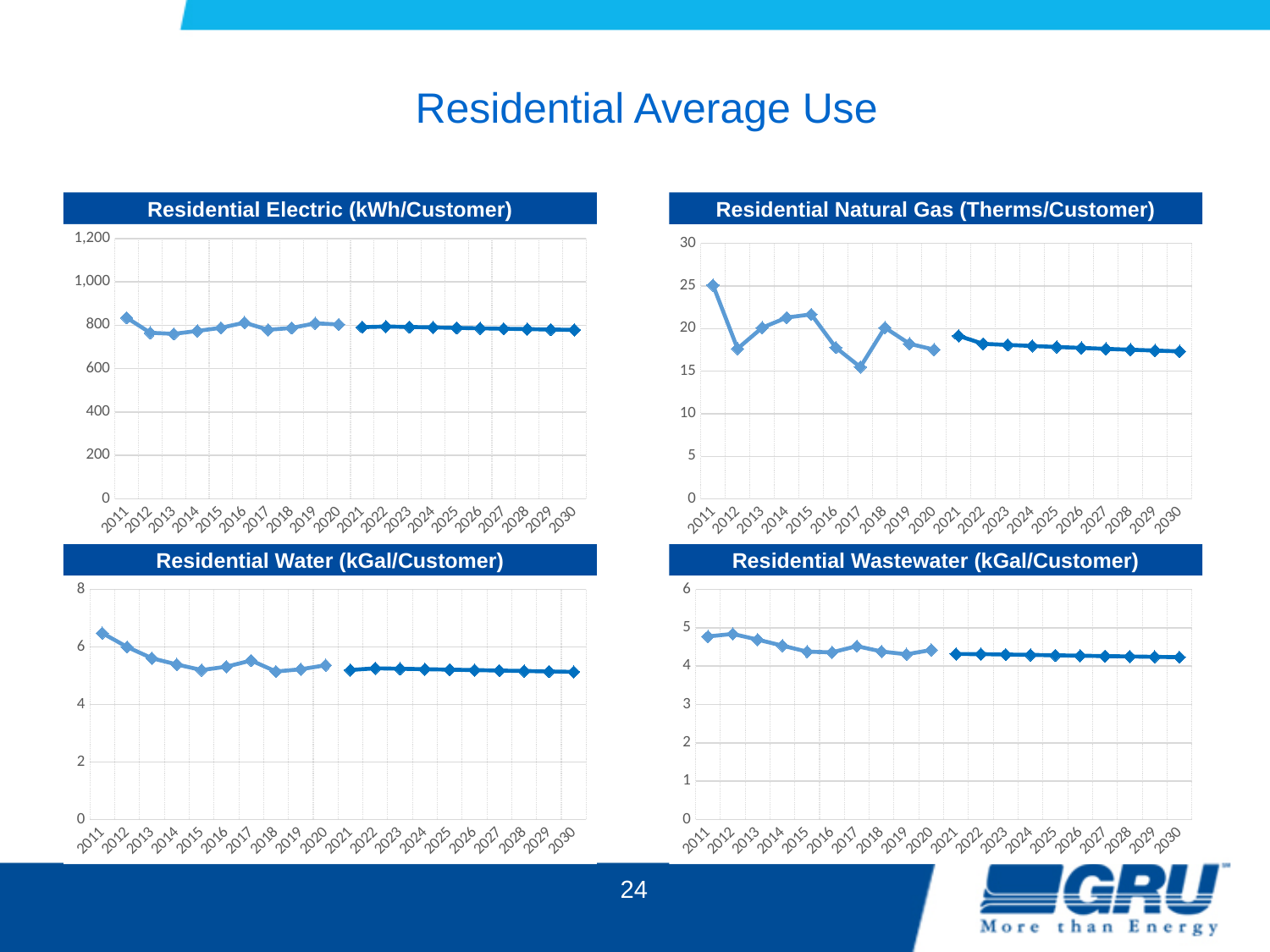
How many years are plotted on the x axis of the Residential Water (kGal/Customer) chart? 20 In the Residential Electric (kWh/Customer) chart, which year has the highest value? 2011 In the Residential Water (kGal/Customer) chart, which year has the highest value? 2011 In the Residential Water (kGal/Customer) chart, is the value for 2011 greater or less than 6? greater In the Residential Electric (kWh/Customer) chart, is the value for 2013 greater or less than 800? less In the Residential Natural Gas (Therms/Customer) chart, which year has the highest value? 2011 In the Residential Natural Gas (Therms/Customer) chart, which year has the lowest value? 2017 What kind of chart is the Residential Electric (kWh/Customer) chart? line chart In the Residential Natural Gas (Therms/Customer) chart, do the values rise or fall from 2021 to 2030? fall In the Residential Wastewater (kGal/Customer) chart, is the value for 2030 greater or less than 4? greater What is the title of the chart in the bottom-right position of the slide? Residential Wastewater (kGal/Customer)